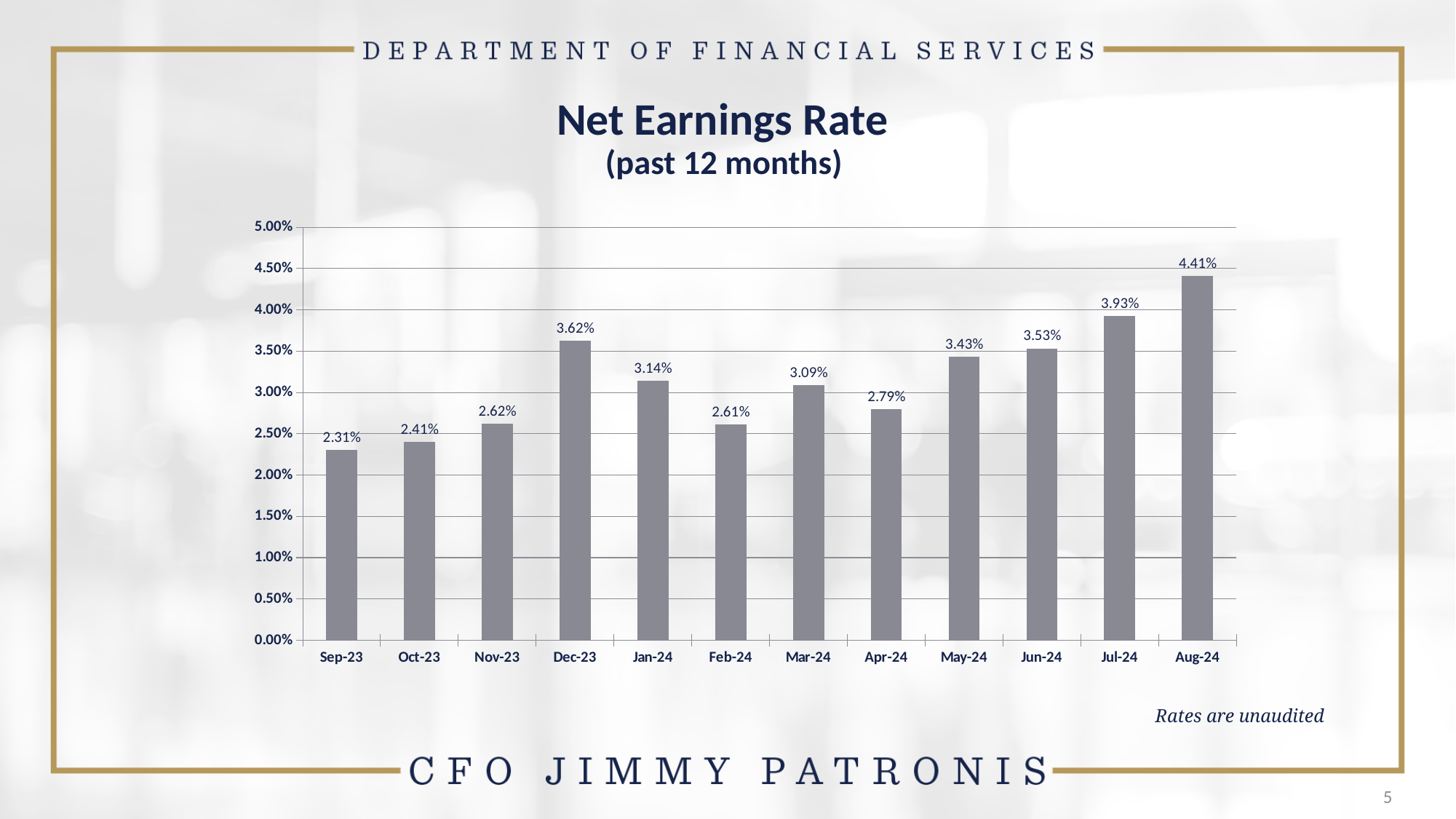
What is the net earnings rate for Apr-24? 2.79% What is the net earnings rate for Jul-24? 3.93% What is the difference between the net earnings rate in Aug-24 and Sep-23? 2.10% What is the difference between the net earnings rate in Dec-23 and Jan-24? 0.48% Is the net earnings rate for Jun-24 greater or less than 3.00%? greater What is the net earnings rate for Dec-23? 3.62% What note appears below the chart about the rates? Rates are unaudited How many months are shown on the chart? 12 Which is larger, the net earnings rate for Mar-24 or for Feb-24? Mar-24 Which month has the highest net earnings rate? Aug-24 Which month has the lowest net earnings rate? Sep-23 What kind of chart is shown on the slide? Bar chart